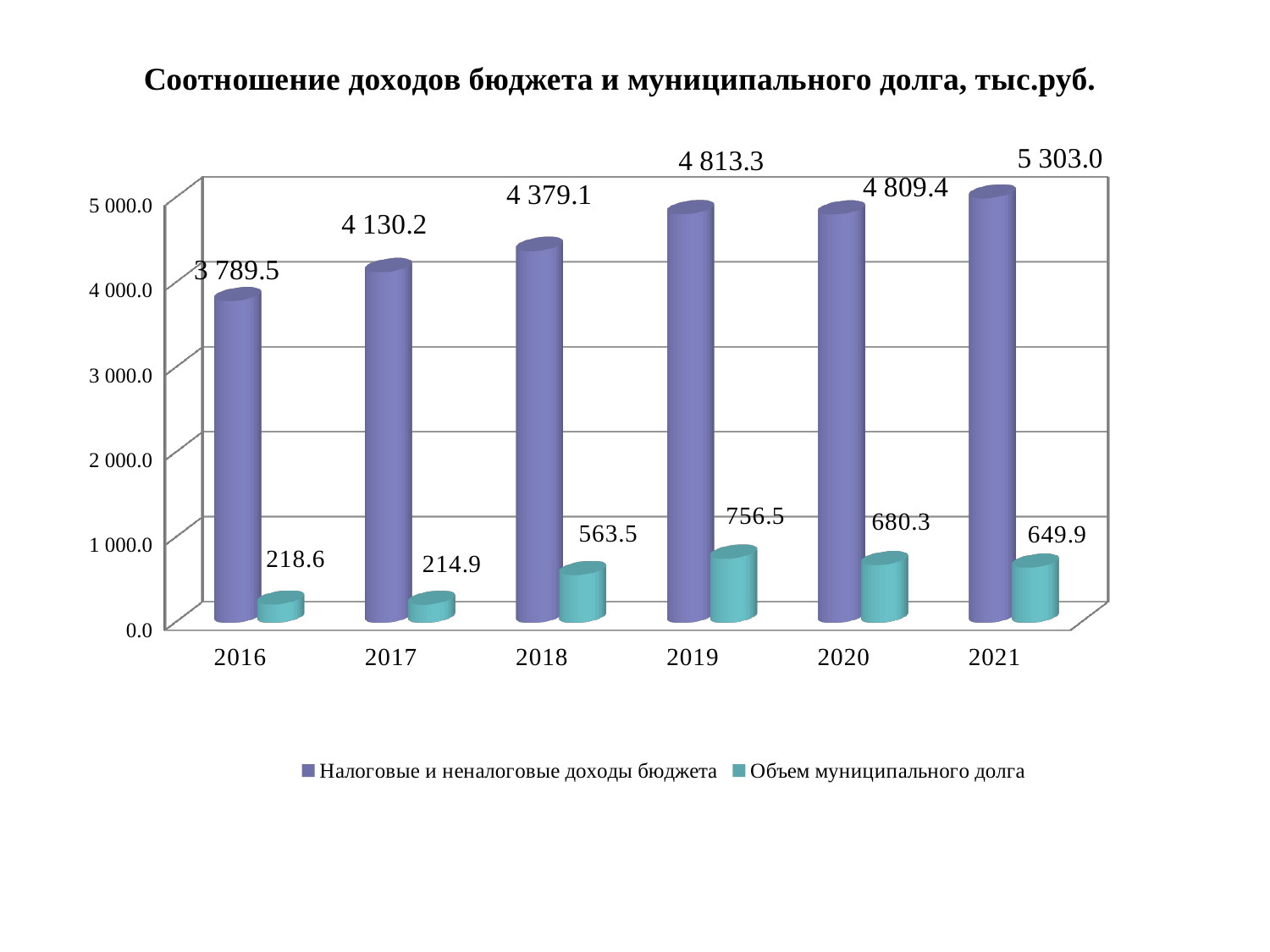
What is the value of Объем муниципального долга for 2019? 756.5 What is the difference between Объем муниципального долга in 2019 and in 2018? 193.0 How many years are shown on the x axis? 6 In which year is Налоговые и неналоговые доходы бюджета the highest? 2021 What kind of chart is shown on the slide? Bar chart Which is larger: Налоговые и неналоговые доходы бюджета in 2019 or in 2020? 2019 What is the difference between Налоговые и неналоговые доходы бюджета in 2021 and in 2016? 1 513.5 What is the value of Налоговые и неналоговые доходы бюджета for 2021? 5 303.0 How many series does the legend list? 2 In which year is Объем муниципального долга the highest? 2019 In which year is Объем муниципального долга the lowest? 2017 What is the value of Налоговые и неналоговые доходы бюджета for 2016? 3 789.5